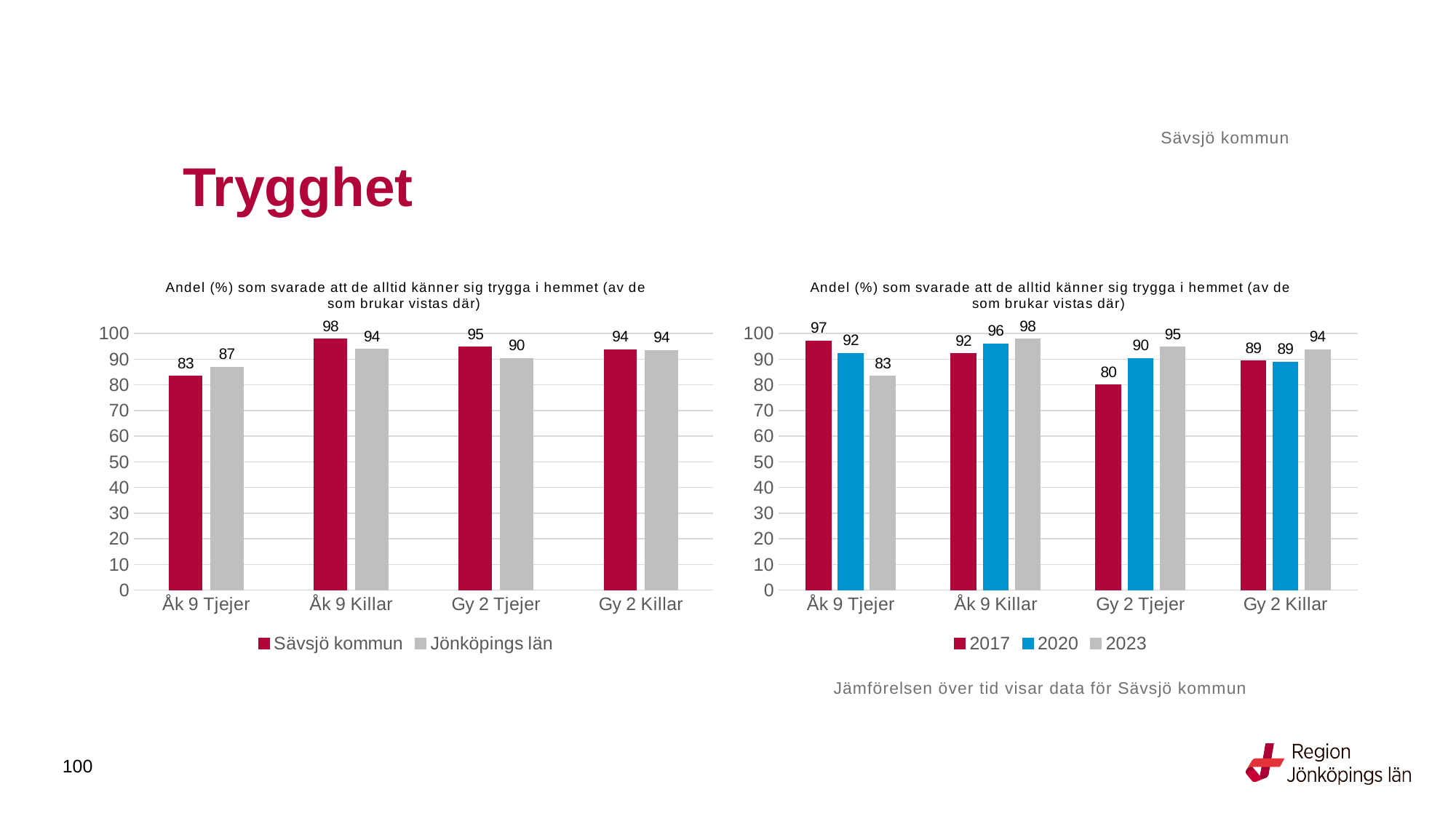
In the left chart, how many series does the legend list? 2 In the right chart, what is the value for 2017 for Gy 2 Tjejer? 80 What kind of chart is the right chart? Bar chart In the right chart, what is the difference between the 2023 and 2017 values for Gy 2 Tjejer? 15 In the right chart, is the value for 2017 or 2023 larger for Åk 9 Tjejer? 2017 In the left chart, what is the difference between Sävsjö kommun and Jönköpings län for Åk 9 Killar? 4 In the left chart, what is the value for Sävsjö kommun for Åk 9 Tjejer? 83 In the right chart, which category has the lowest value for 2023? Åk 9 Tjejer In the right chart, what is the value for 2023 for Åk 9 Killar? 98 In the right chart, how many categories are shown on the x axis? 4 In the left chart, what is the value for Jönköpings län for Gy 2 Tjejer? 90 In the left chart, which category has the highest value for Sävsjö kommun? Åk 9 Killar